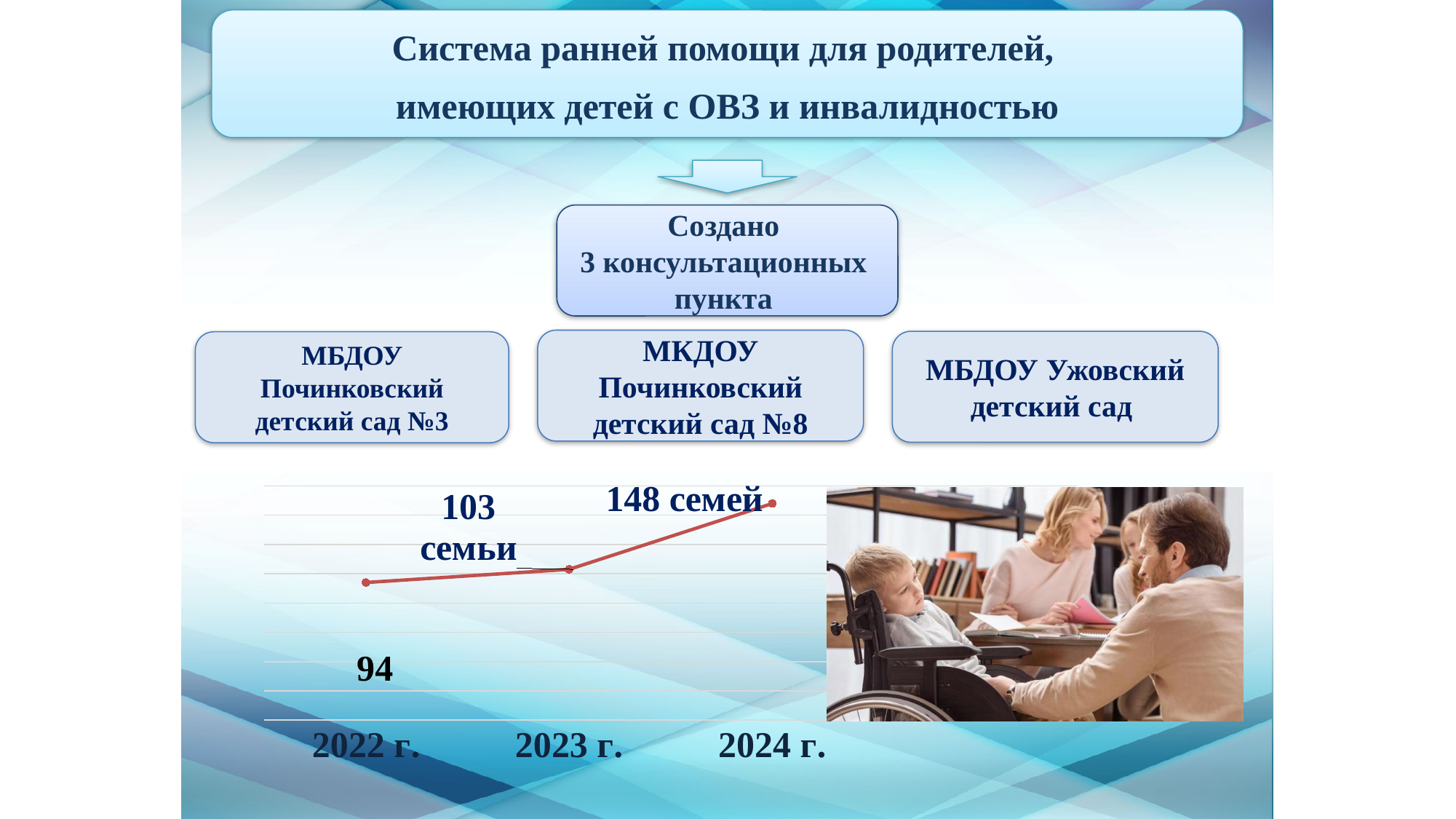
What colour is the line on the chart? red Which year has the lowest value on the line chart? 2022 г. How many data points are plotted on the line chart? 3 Which is larger on the line chart: the value for 2022 г. or the value for 2024 г.? 2024 г. What is the value shown for 2022 г. on the line chart? 94 Do the values on the line chart rise or fall from 2022 г. to 2024 г.? rise What is the value shown for 2023 г. on the line chart? 103 семьи What is the difference between the values for 2023 г. and 2022 г.? 9 Which year has the highest value on the line chart? 2024 г. What is the value shown for 2024 г. on the line chart? 148 семей By how much does the value for 2024 г. exceed the value for 2023 г.? 45 What kind of chart is shown at the bottom of the slide? line chart